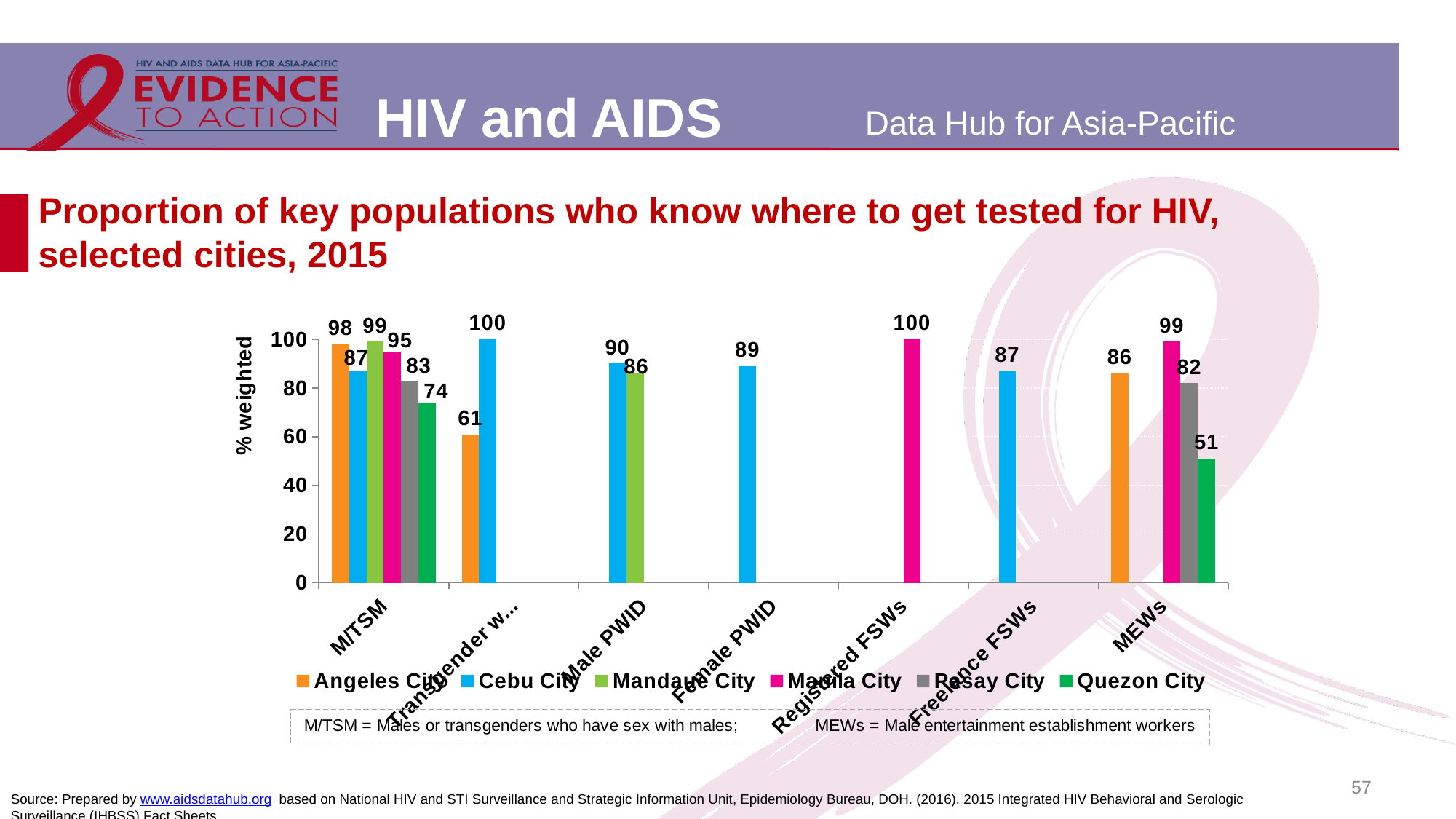
What type of chart is shown on the slide? bar chart What is the label of the vertical axis? % weighted How many series does the legend list? 6 What is the difference between the Cebu City and Mandaue City values in the Male PWID category? 4 Which city has the highest value in the M/TSM category? Mandaue City Is the value for Quezon City in the M/TSM category greater or less than 80? less What is the value for Manila City in the Registered FSWs category? 100 What is the value for Angeles City in the Transgender category? 61 Which is larger in the MEWs category: the value for Angeles City or the value for Pasay City? Angeles City Which city has the lowest value in the MEWs category? Quezon City What is the value for Quezon City in the MEWs category? 51 What is the value for Cebu City in the M/TSM category? 87